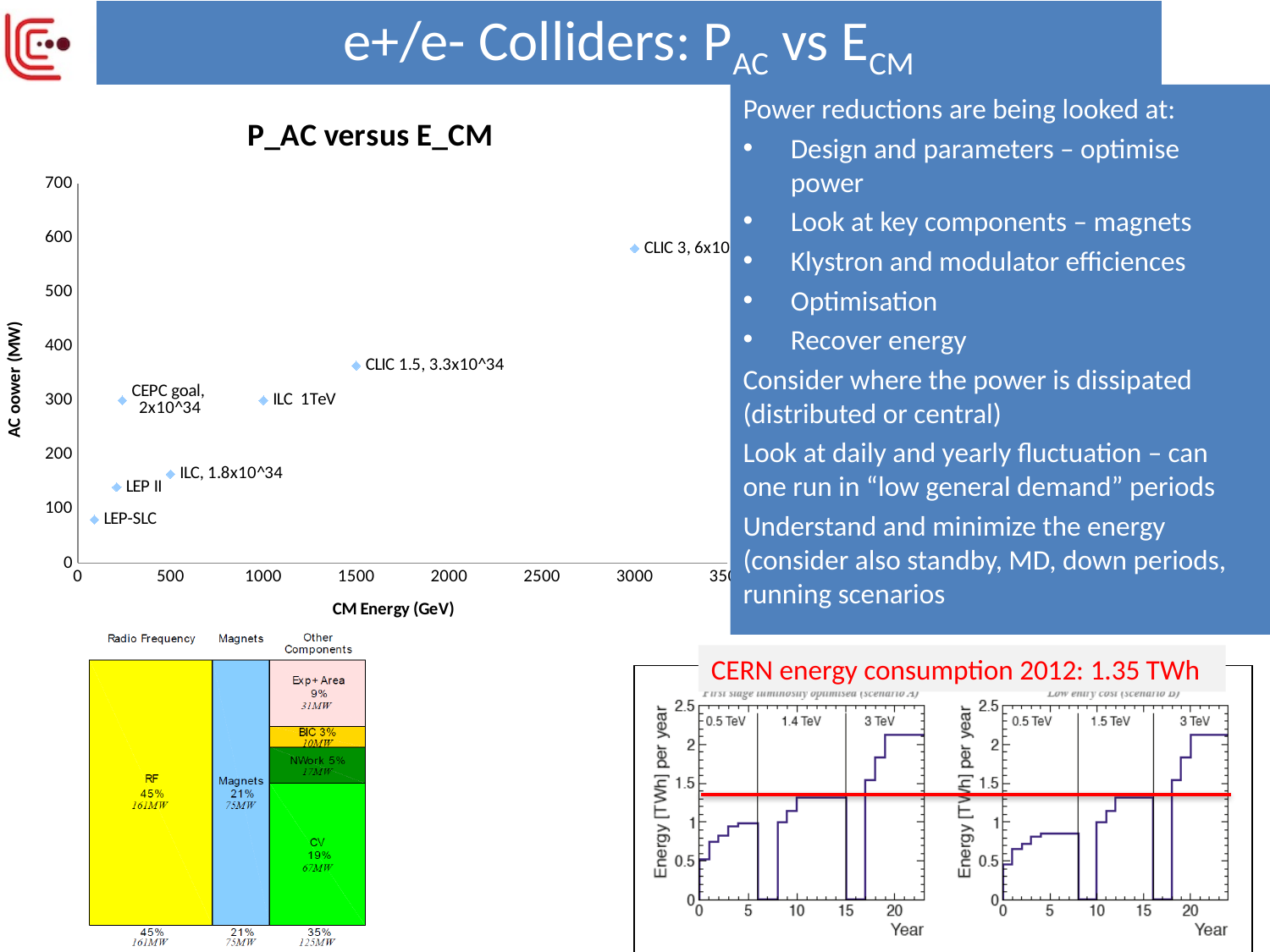
In the power breakdown chart at the bottom left, what share of power goes to RF? 45% In the 'P_AC versus E_CM' chart, what kind of chart is it? scatter chart In the 'P_AC versus E_CM' chart, is the AC power for CLIC 1.5, 3.3x10^34 greater or less than 300 MW? greater In the 'P_AC versus E_CM' chart, which collider has the highest AC power? CLIC 3, 6x10^34 In the power breakdown chart at the bottom left, what is the difference in MW between RF and Magnets? 86MW In the 'P_AC versus E_CM' chart, is the AC power for LEP-SLC greater or less than 100 MW? less In the 'P_AC versus E_CM' chart, what is the label of the x axis? CM Energy (GeV) In the power breakdown chart at the bottom left, how many MW go to Magnets? 75MW In the 'P_AC versus E_CM' chart, which collider has the lowest AC power? LEP-SLC In the 'P_AC versus E_CM' chart, which has the higher AC power, ILC 1TeV or LEP II? ILC 1TeV In the 'P_AC versus E_CM' chart, how many data points are plotted? 7 In the 'P_AC versus E_CM' chart, is the AC power for CLIC 3, 6x10^34 greater or less than 500 MW? greater